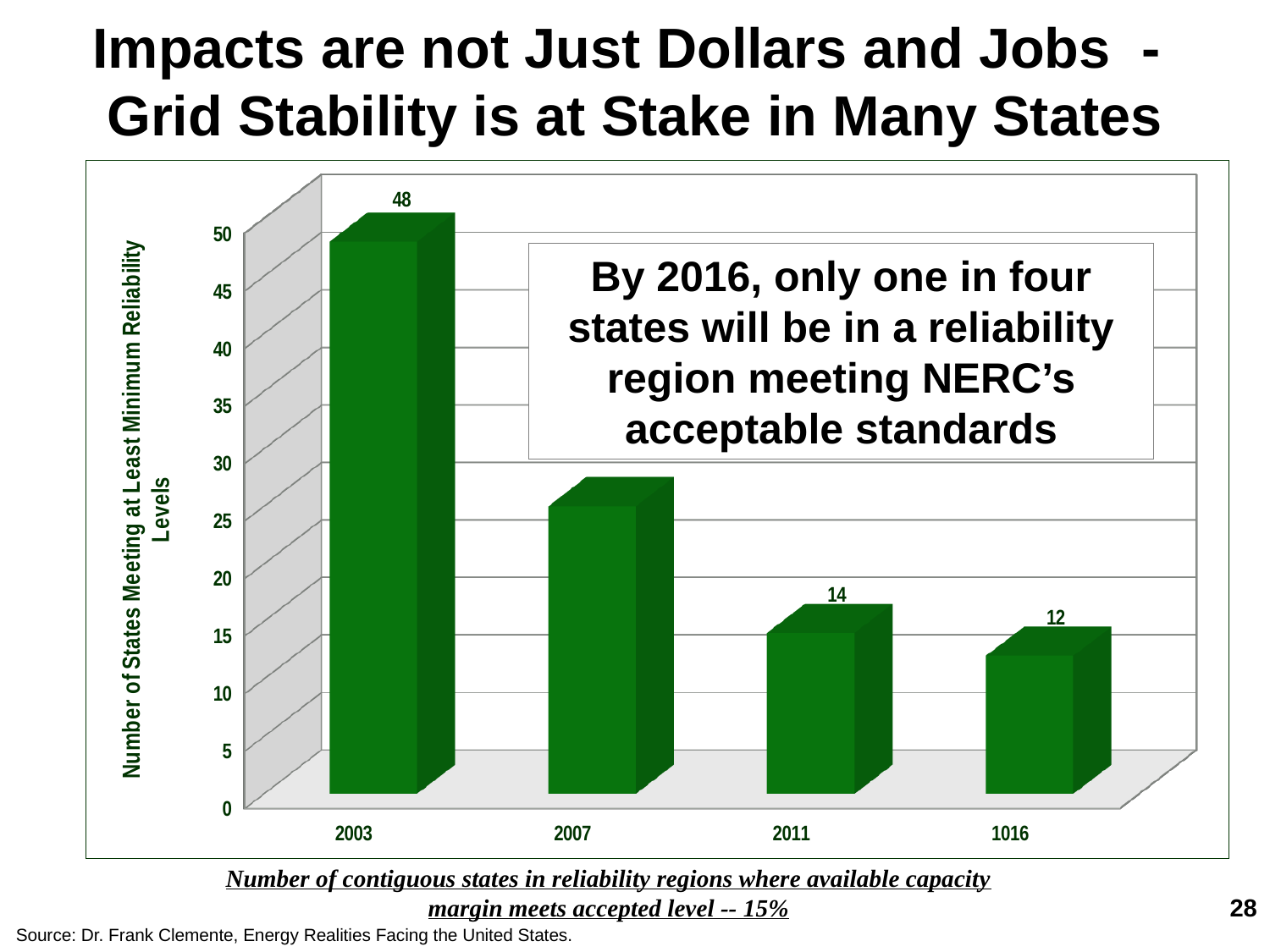
Is the value for 2007 greater or less than 20? greater What kind of chart is shown? bar chart Is the value for 2007 greater or less than 30? less What is the value for the last category on the x axis (labelled 1016)? 12 What is the value for 2003? 48 What is the difference between the values for 2011 and 1016? 2 Which is larger, the value for 2003 or the value for 2007? 2003 Which category has the lowest value? 1016 How many categories are shown on the x axis? 4 What is the value for 2011? 14 What is the difference between the values for 2003 and 2011? 34 Which category has the highest value? 2003